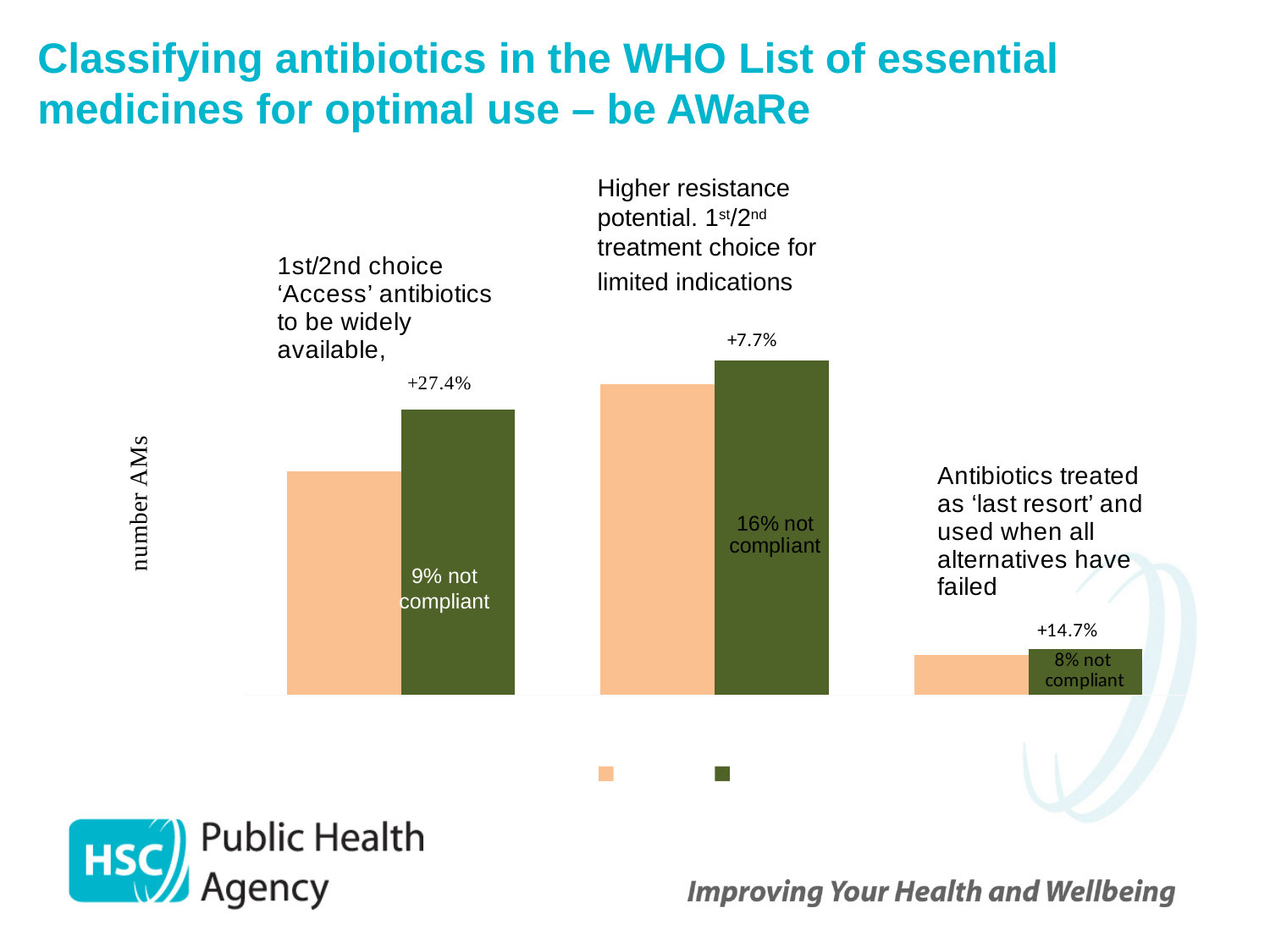
What is the label on the vertical axis of the chart? number AMs Which group of bars has the tallest bars: left, middle or right? middle What 'not compliant' percentage is printed on the dark green bar of the middle group? 16% not compliant Which group of bars has the shortest bars: left, middle or right? right What 'not compliant' percentage is printed on the dark green bar of the left group? 9% not compliant What percentage change is printed above the left group of bars ('Access' antibiotics)? +27.4% What percentage change is printed above the middle group of bars (higher resistance potential)? +7.7% How many groups of bars are plotted in the chart? 3 What percentage change is printed above the right group of bars ('last resort' antibiotics)? +14.7% How many series (colour swatches) does the legend show? 2 What 'not compliant' percentage is printed on the dark green bar of the right group? 8% not compliant What type of chart is shown on the slide? bar chart